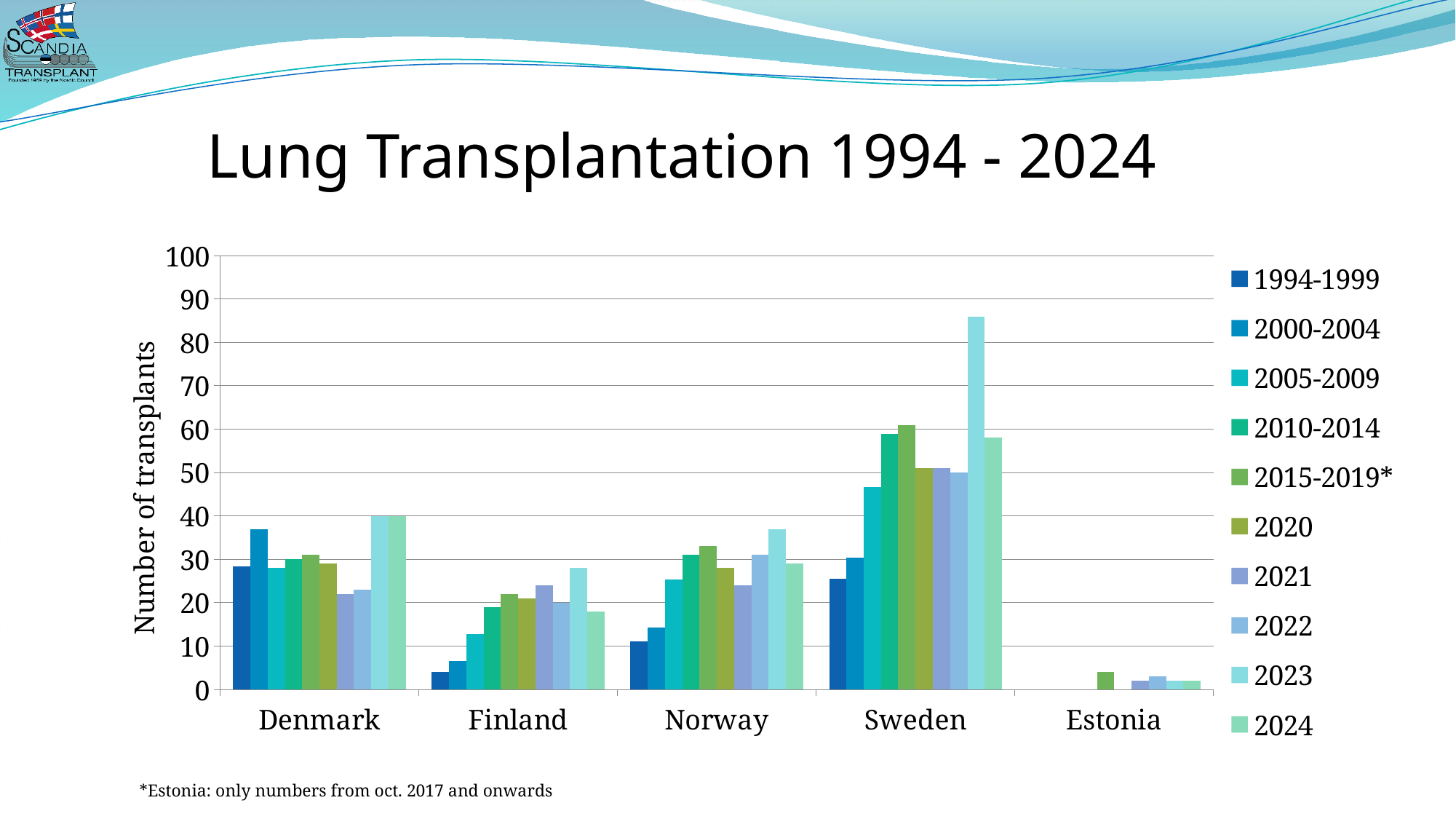
Which country has the lowest number of transplants overall? Estonia How many countries are shown on the x axis of the chart? 5 Which country has the tallest bar in the chart? Sweden Which is larger for Sweden: the 2023 value or the 2024 value? 2023 Is the value for Norway in 2023 greater or less than 30? greater What type of chart is shown on the slide? bar chart What is the title of the y axis? Number of transplants Which country has the larger value for 2000-2004: Denmark or Finland? Denmark Is the value for Sweden in 2023 greater or less than 80? greater Do Finland's values rise or fall from 1994-1999 through 2015-2019*? rise How many series does the legend list? 10 Is the value for Finland in 1994-1999 greater or less than 10? less